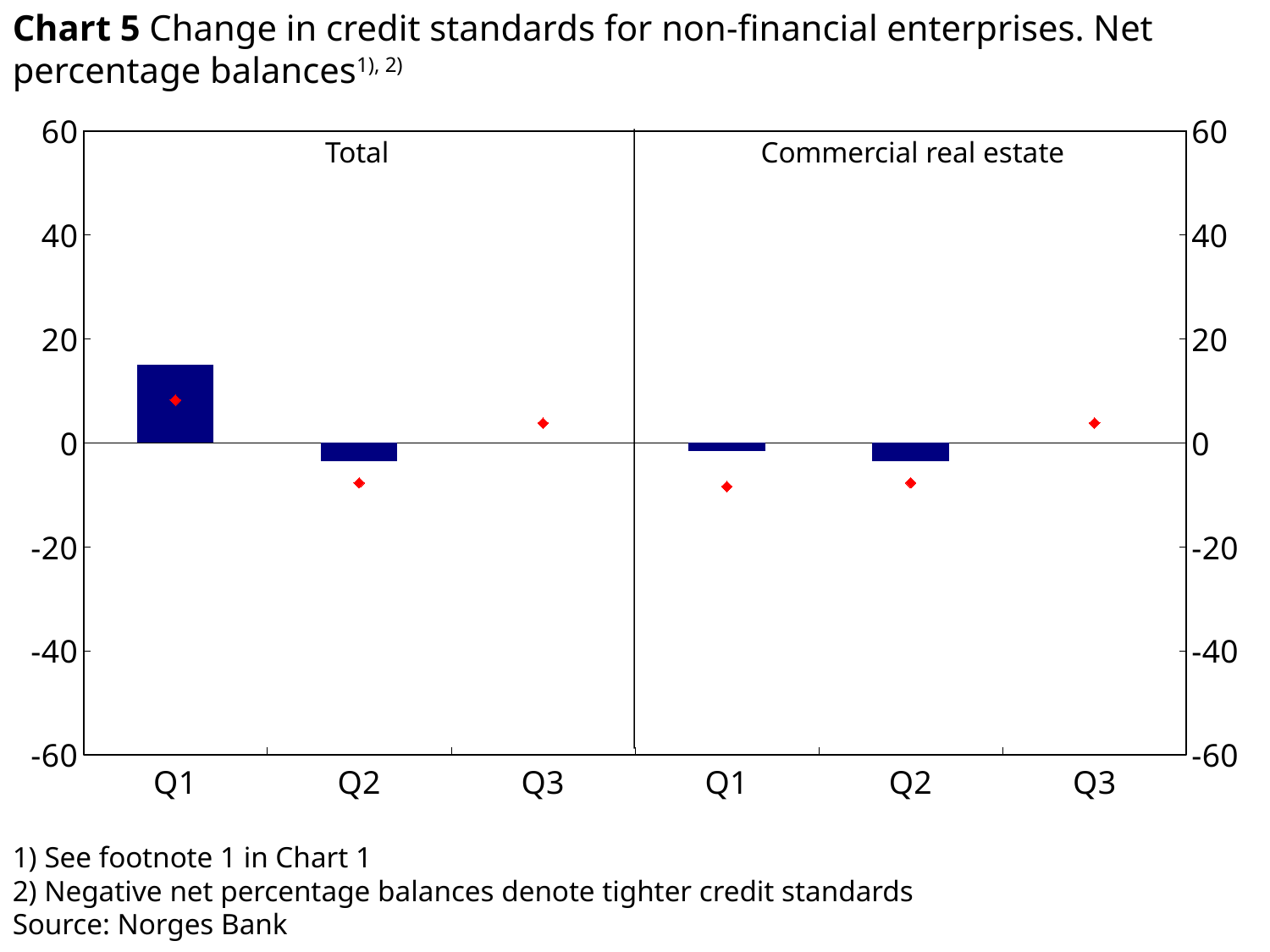
In the Total panel, which quarter has the highest bar? Q1 Is the red diamond for Q2 in the Total panel greater or less than 0? less Do the bars in the Total panel rise or fall from Q1 to Q2? fall What kind of chart is Chart 5? bar chart Which is larger, the Q1 bar in the Total panel or the Q1 bar in the Commercial real estate panel? Q1 in the Total panel What are the names of the two panels in the chart? Total and Commercial real estate Is the bar for Q1 in the Total panel greater or less than 20? less Is the red diamond for Q3 in the Commercial real estate panel greater or less than 0? greater How many quarters are shown in each panel of the chart? 3 What is the source given for the chart? Norges Bank